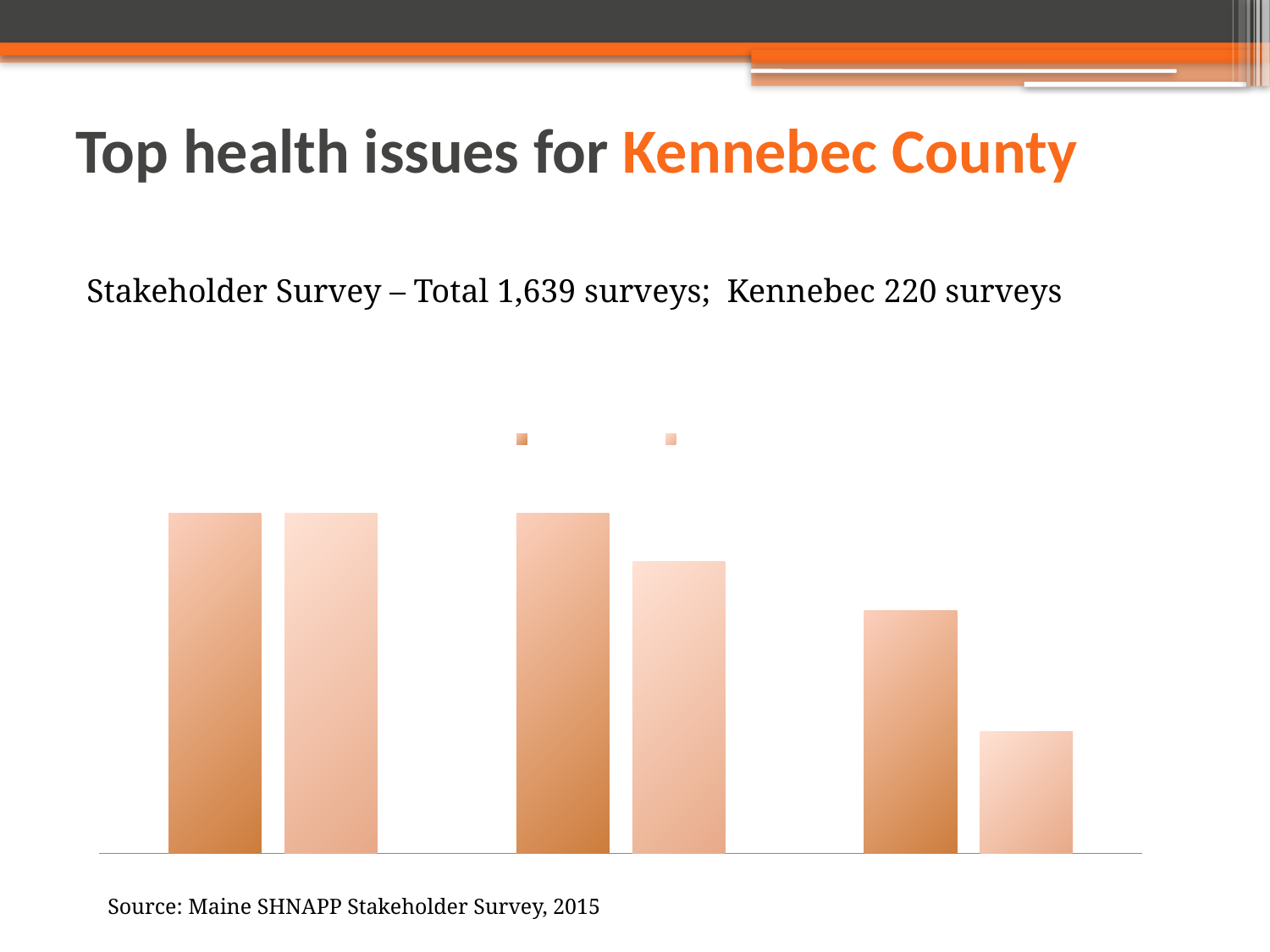
How many series does the chart's legend show? 2 What colour are the bars in the chart? orange How many bars are plotted in total in the chart? 6 In the rightmost group of bars, is the darker bar or the lighter bar taller? the darker bar Do the bar heights generally rise or fall from left to right across the chart? fall In the middle group of bars, is the darker bar or the lighter bar taller? the darker bar How many groups of bars are plotted in the chart? 3 What kind of chart is shown on the slide? bar chart Which group of bars contains the shortest bar in the chart: the left, middle, or right group? the right group